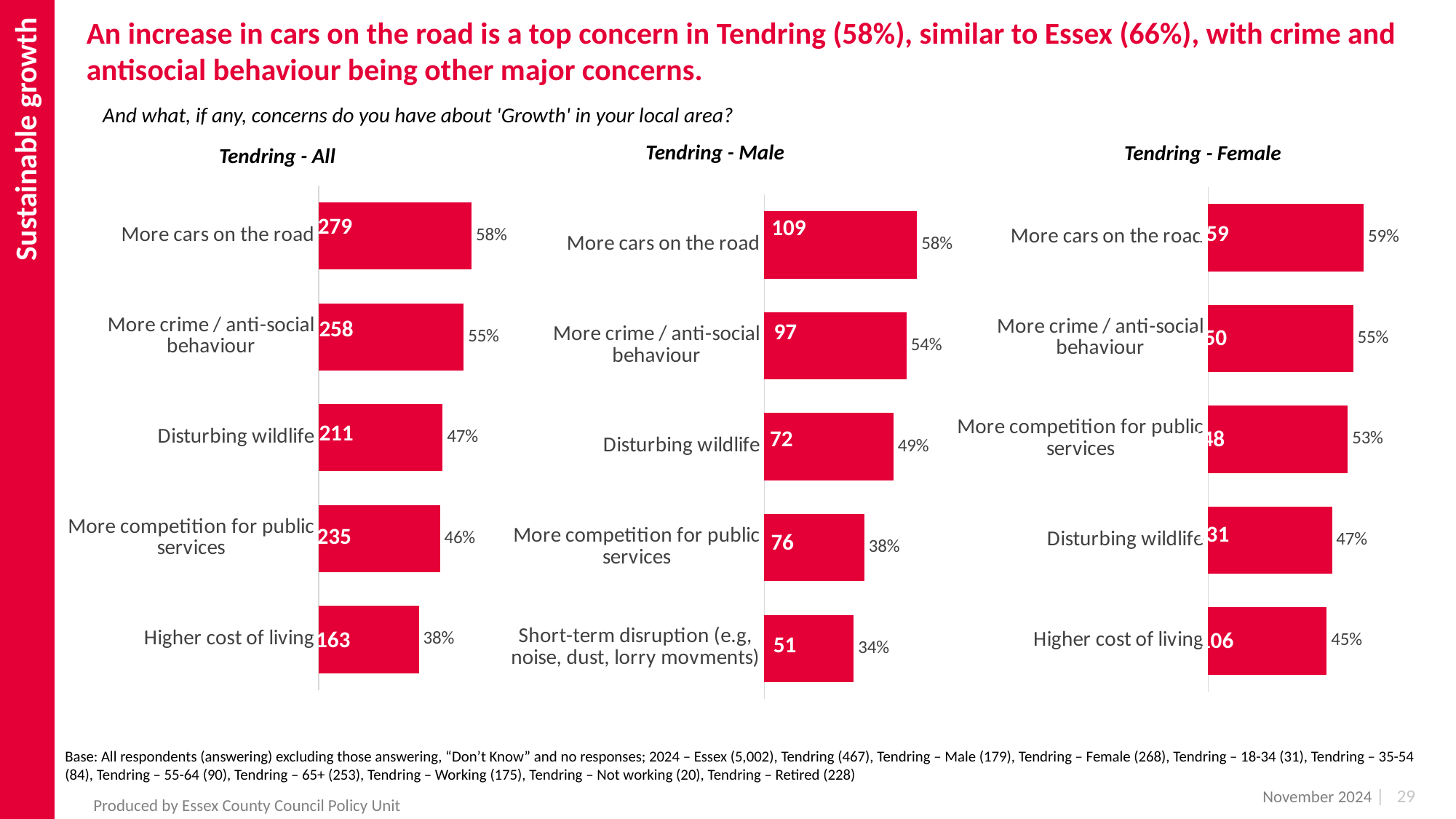
What type of chart is the Tendring - All chart? Bar chart In the Tendring - All chart, what count is shown inside the bar for 'Higher cost of living'? 163 In the Tendring - All chart, what percentage is shown for 'More cars on the road'? 58% In the Tendring - All chart, which concern has the lowest percentage? Higher cost of living In the Tendring - Female chart, what percentage is shown for 'Higher cost of living'? 45% In the Tendring - Male chart, which is larger: the percentage for 'More competition for public services' or for 'Short-term disruption (e.g, noise, dust, lorry movments)'? More competition for public services In the Tendring - Male chart, which concern has the highest percentage? More cars on the road In the Tendring - Male chart, what percentage is shown for 'Disturbing wildlife'? 49% In the Tendring - Female chart, what percentage is shown for 'More competition for public services'? 53% In the Tendring - All chart, what is the difference in percentage points between 'More cars on the road' and 'Higher cost of living'? 20 In the Tendring - Male chart, what count is shown inside the bar for 'More crime / anti-social behaviour'? 97 How many concerns are listed in the Tendring - Female chart? 5